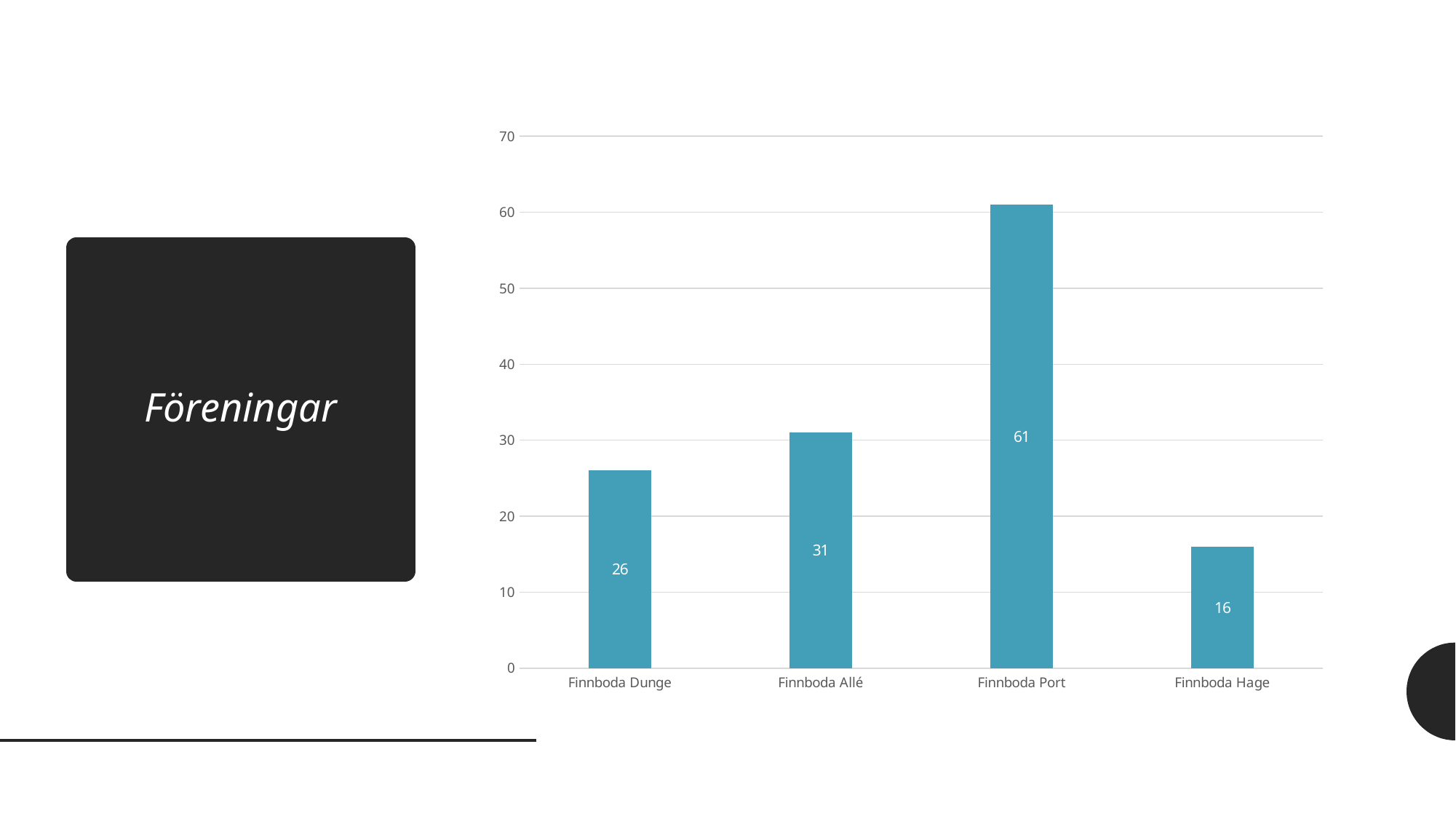
What is the value for Finnboda Hage? 16 How many categories are shown on the x axis? 4 What is the difference between the values for Finnboda Port and Finnboda Allé? 30 Is the value for Finnboda Port greater or less than 50? greater What is the value for Finnboda Port? 61 What kind of chart is shown on the slide? bar chart Which category has the highest value? Finnboda Port Which category has the lowest value? Finnboda Hage Which is larger, the value for Finnboda Dunge or the value for Finnboda Allé? Finnboda Allé What is the value for Finnboda Allé? 31 What is the difference between the values for Finnboda Dunge and Finnboda Hage? 10 What is the value for Finnboda Dunge? 26